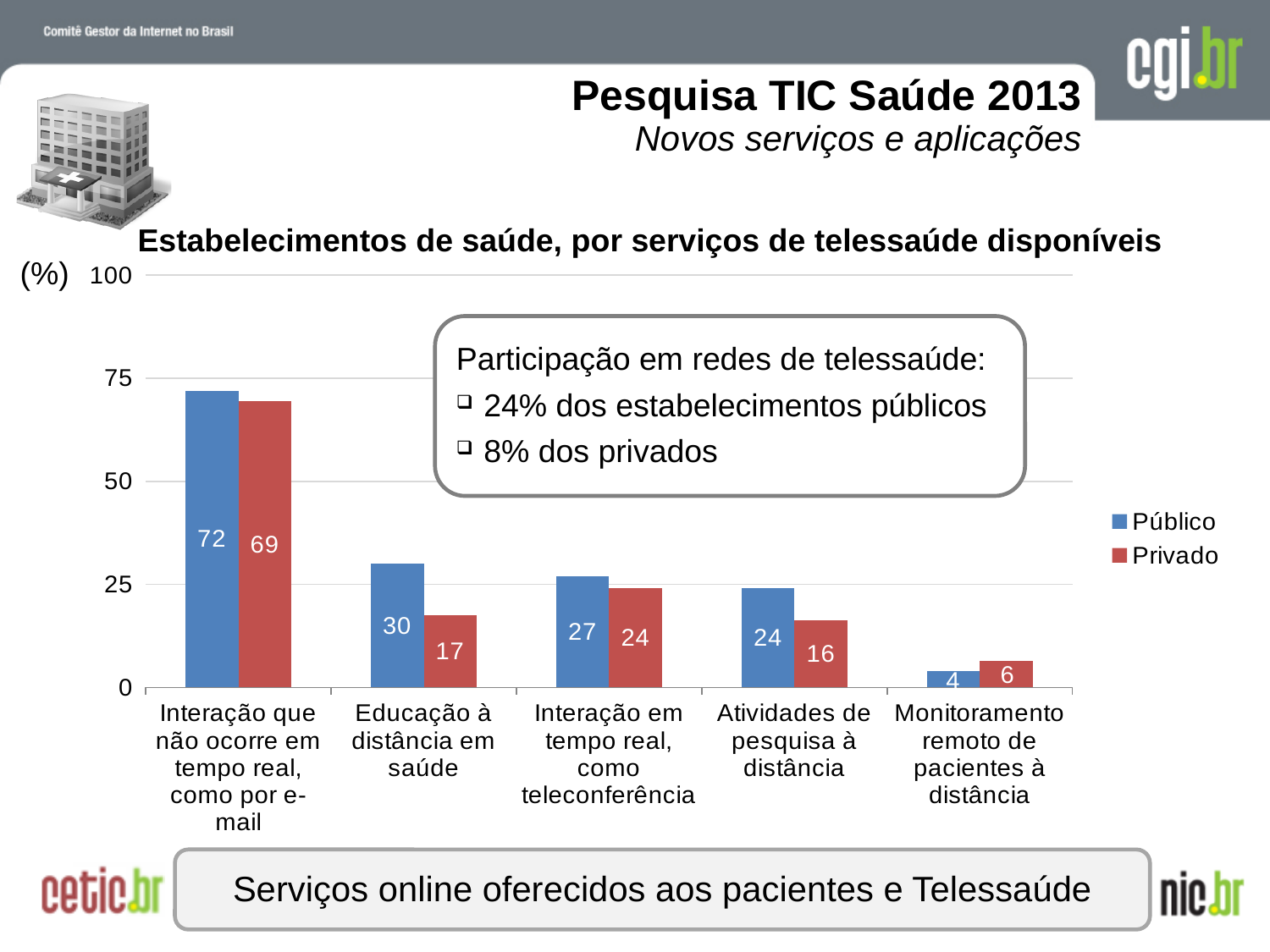
What is the Privado value for "Monitoramento remoto de pacientes à distância"? 6 How many categories are shown on the x axis? 5 How many series does the legend list? 2 What is the difference between the Público and Privado values for "Educação à distância em saúde"? 13 What kind of chart is shown on the slide? Bar chart Which category has the highest Público value? Interação que não ocorre em tempo real, como por e-mail Is the Público value for "Interação em tempo real, como teleconferência" greater or less than 25? greater What is the Público value for "Interação que não ocorre em tempo real, como por e-mail"? 72 Which category has the lowest Privado value? Monitoramento remoto de pacientes à distância What is the Privado value for "Educação à distância em saúde"? 17 Which is larger for "Atividades de pesquisa à distância": the Público value or the Privado value? Público What are the two series named in the legend? Público and Privado